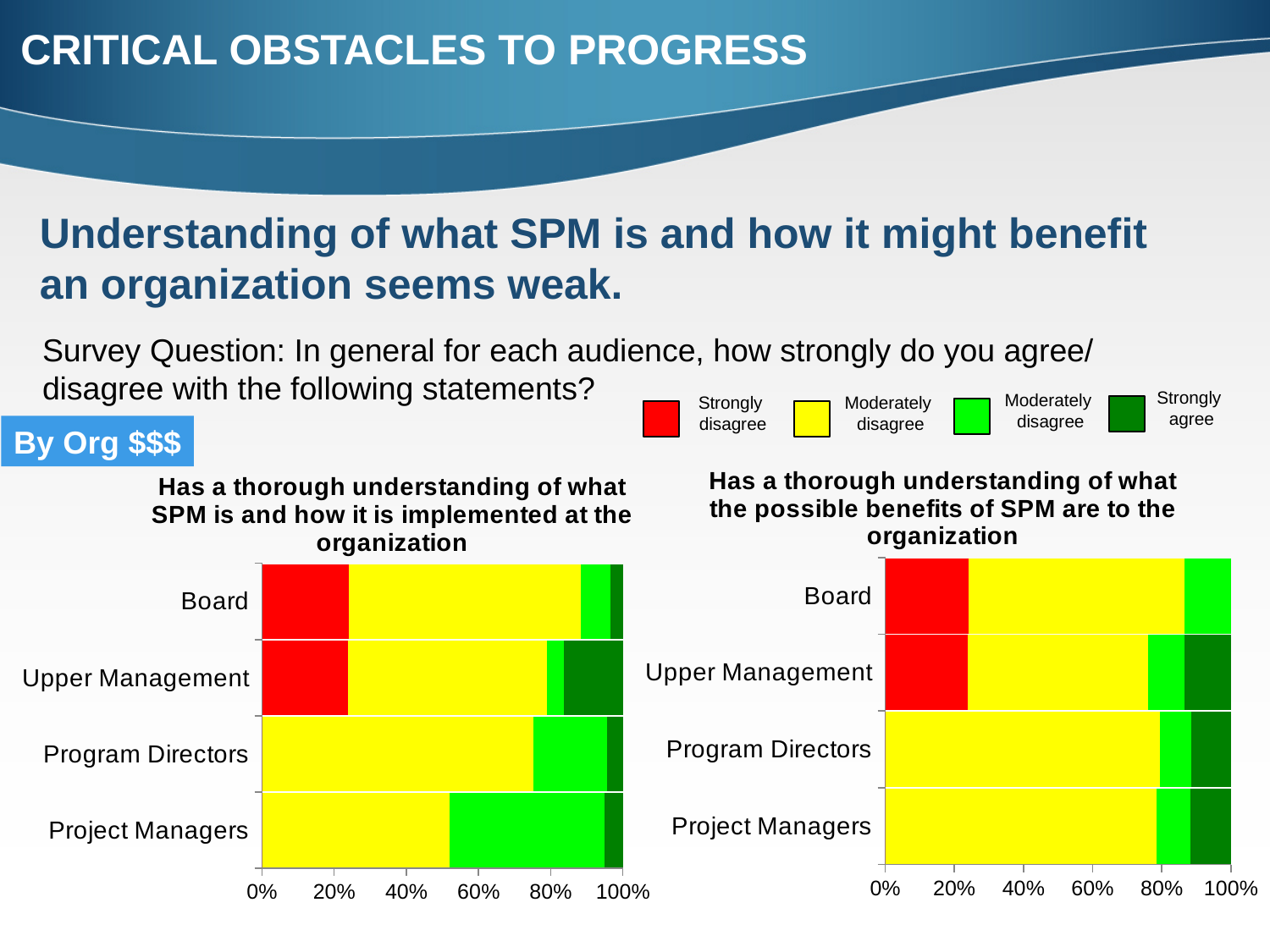
Which colour represents "Strongly disagree" in the legend? Red How many series does the shared legend list for the two charts? 4 On the right chart, which category has no "Strongly agree" (dark green) segment? Board On the left chart, which categories have no "Strongly disagree" (red) segment? Program Directors and Project Managers How many audience categories are shown on the right chart, titled "Has a thorough understanding of what the possible benefits of SPM are to the organization"? 4 On the left chart, is the "Strongly disagree" (red) share for Board greater or less than 40%? less On the right chart, is the "Moderately disagree" (yellow) share for Program Directors greater or less than 60%? greater On the left chart, which has the larger yellow segment: Board or Program Directors? Program Directors On the left chart, is the "Moderately disagree" (yellow) share for Project Managers greater or less than 60%? less On the left chart, which category has the largest bright green (third legend entry) segment? Project Managers On the left chart, which category has the largest "Strongly agree" (dark green) segment? Upper Management What kind of chart is the left chart, titled "Has a thorough understanding of what SPM is and how it is implemented at the organization"? Stacked bar chart